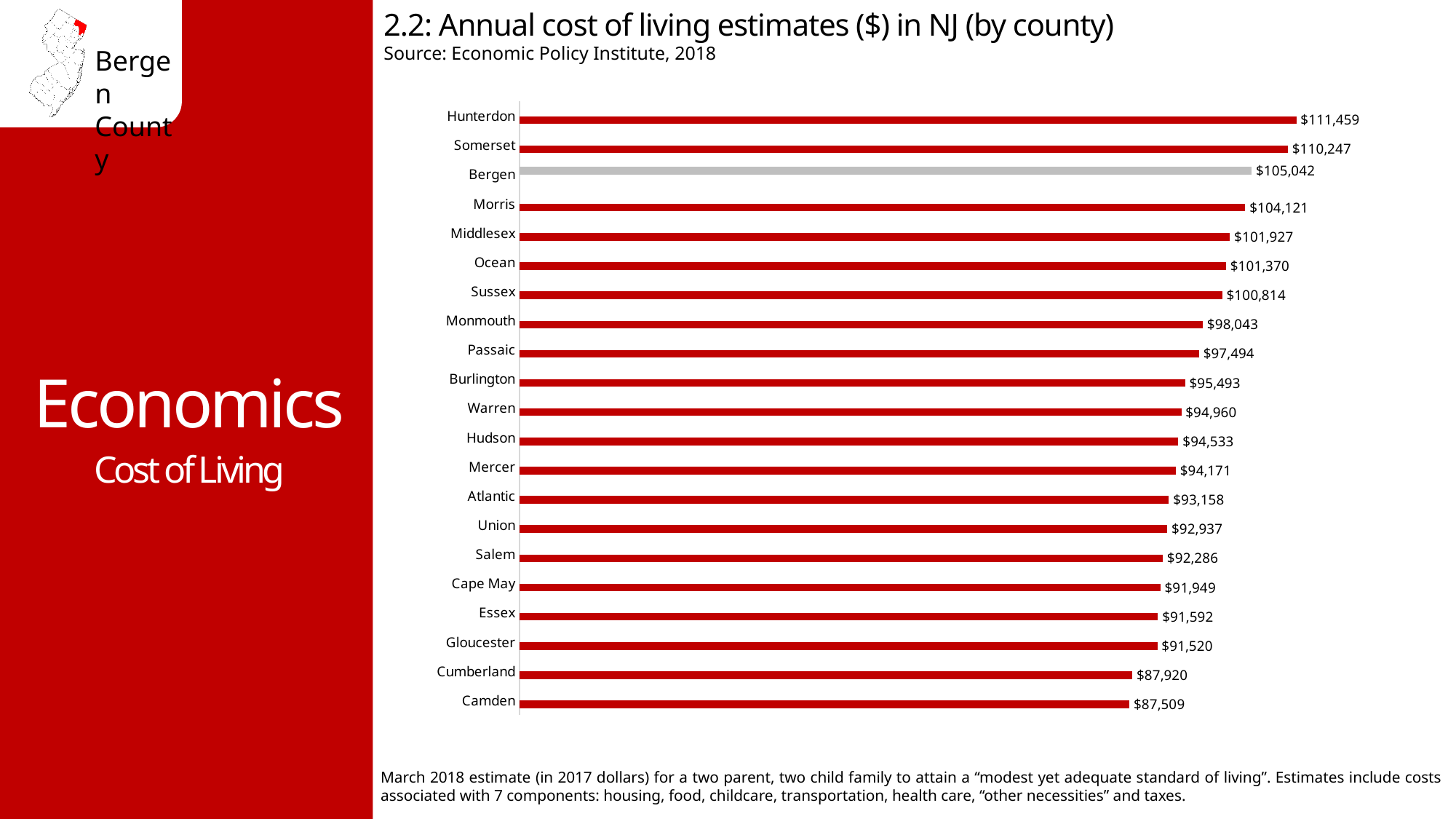
What is the annual cost of living estimate for Camden County? $87,509 What kind of chart is used on this slide? Bar chart What is the difference between the cost of living estimates for Bergen and Camden? $17,533 Which county's bar is shown in grey rather than red? Bergen Which county has the lowest annual cost of living estimate? Camden What is the annual cost of living estimate for Bergen County? $105,042 Which county has a higher cost of living estimate, Morris or Middlesex? Morris Which county has the highest annual cost of living estimate? Hunterdon What is the source cited for the chart? Economic Policy Institute, 2018 What is the annual cost of living estimate for Monmouth County? $98,043 How many counties are shown in the chart? 21 What is the difference between the cost of living estimates for Hunterdon and Somerset? $1,212